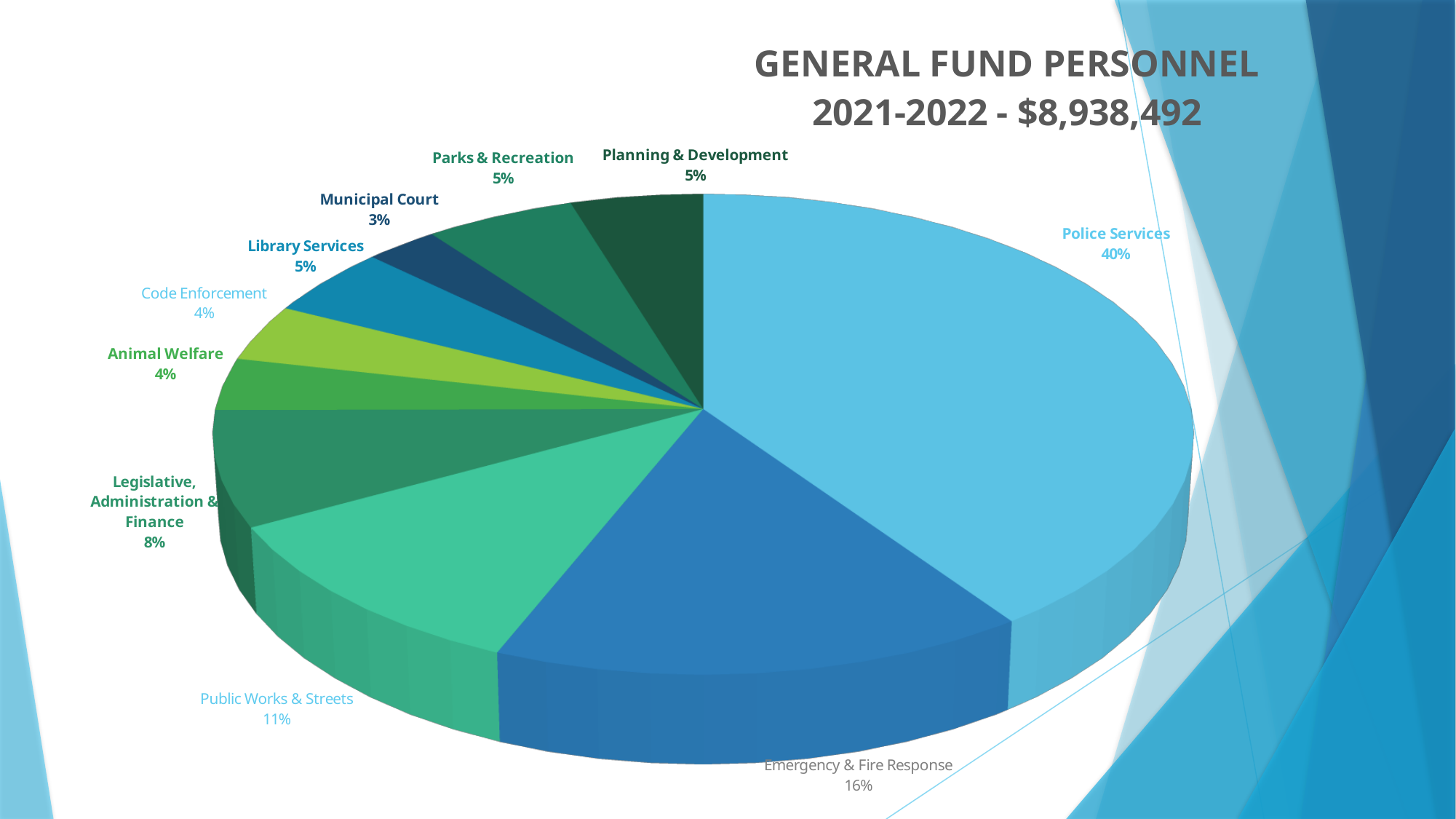
What percentage is shown for Municipal Court? 3% Which category has the smallest share of the pie? Municipal Court What kind of chart is shown on the slide? Pie chart What is the difference in percentage points between Police Services and Emergency & Fire Response? 24 Which is larger, the share for Public Works & Streets or the share for Legislative, Administration & Finance? Public Works & Streets Which category has the largest share of the pie? Police Services How many categories are shown in the pie chart? 10 What percentage is shown for Emergency & Fire Response? 16% What total dollar amount is given in the chart title? $8,938,492 What percentage is shown for Public Works & Streets? 11% What percentage is shown for Legislative, Administration & Finance? 8% What share of the pie does Police Services represent? 40%